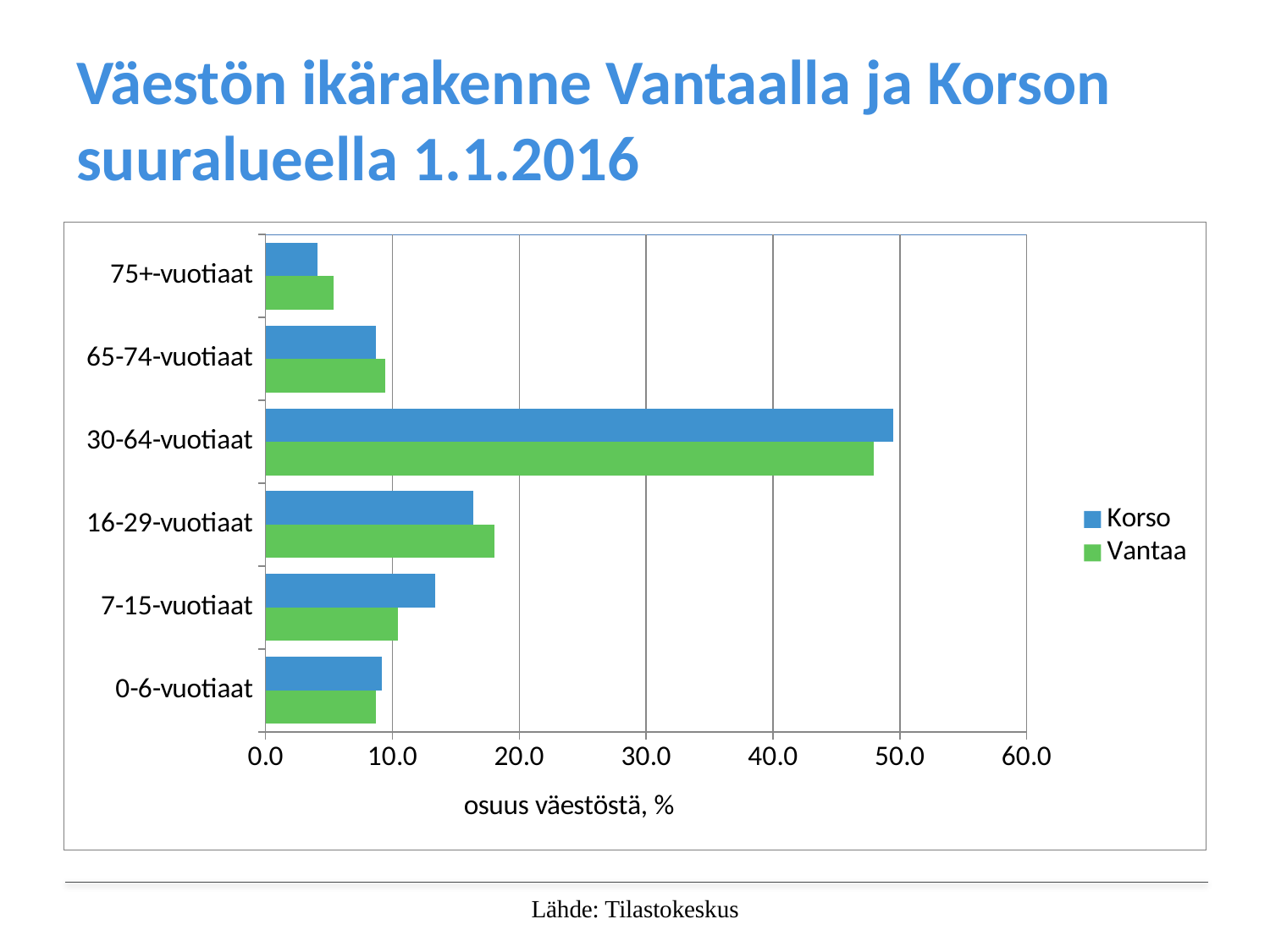
Is the value for Korso in the 7-15-vuotiaat group greater or less than 10.0? greater How many series does the legend list? 2 What is the title of the horizontal axis? osuus väestöstä, % In the 16-29-vuotiaat group, which is larger, Korso or Vantaa? Vantaa Is the value for Vantaa in the 75+-vuotiaat group greater or less than 10.0? less Is the value for Korso in the 30-64-vuotiaat group greater or less than 40.0? greater How many age groups are shown on the chart? 6 Which age group has the lowest value for Vantaa? 75+-vuotiaat Which age group has the highest value for Korso? 30-64-vuotiaat In the 7-15-vuotiaat group, which is larger, Korso or Vantaa? Korso What kind of chart is shown on the slide? bar chart